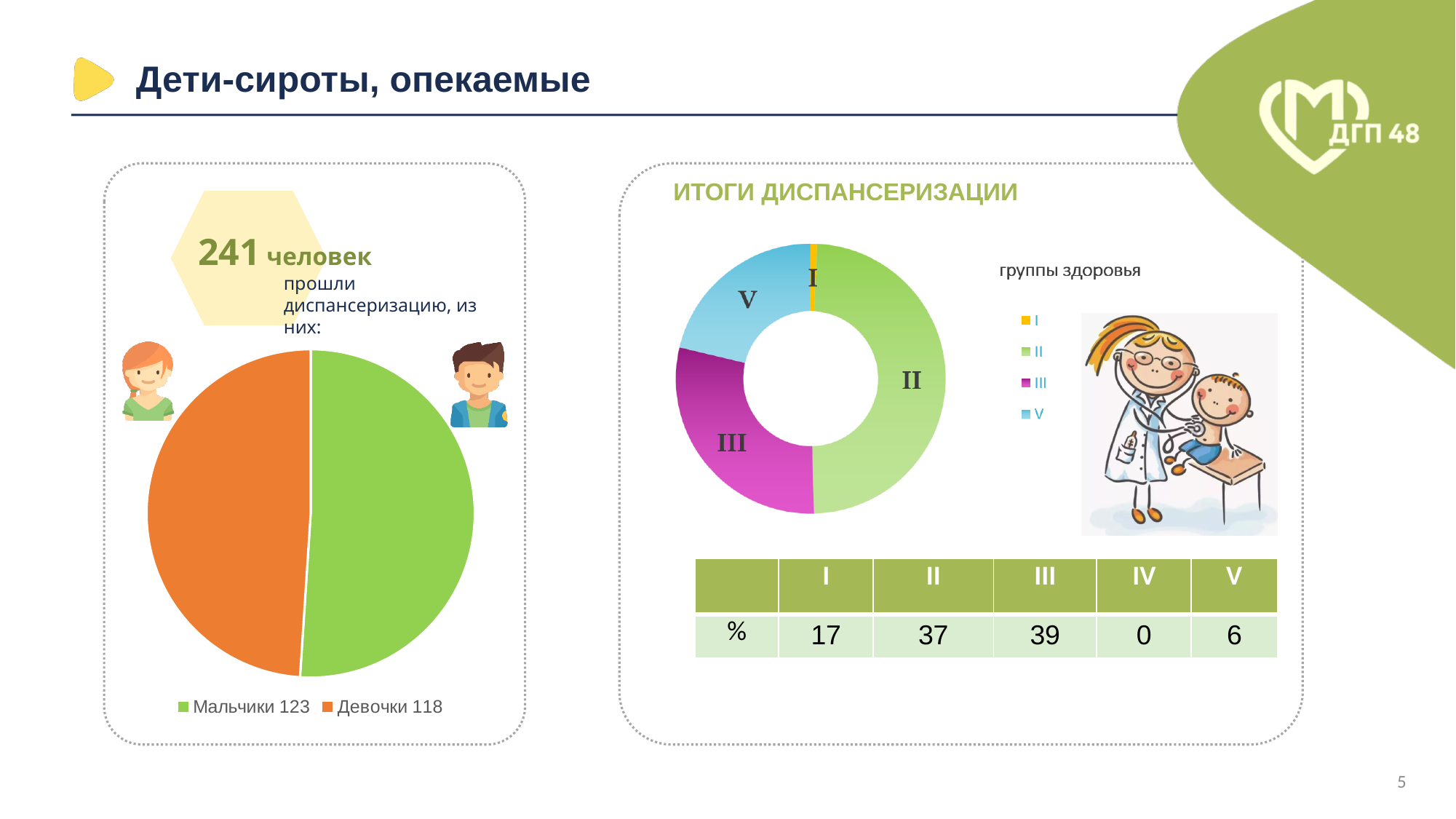
On the chart titled ИТОГИ ДИСПАНСЕРИЗАЦИИ, which health group has the largest segment? II On the left pie chart, what is the value for Мальчики? 123 What kind of chart is the one on the left of the slide? pie chart On the left pie chart, which category has the larger value, Мальчики or Девочки? Мальчики On the chart titled ИТОГИ ДИСПАНСЕРИЗАЦИИ, which health group has the smallest segment? I On the left pie chart, what is the difference between the values for Мальчики and Девочки? 5 On the left pie chart, what is the value for Девочки? 118 On the left pie chart, what colour is the Девочки slice? orange What kind of chart is the one titled ИТОГИ ДИСПАНСЕРИЗАЦИИ? doughnut chart On the left pie chart, how many categories are shown? 2 On the chart titled ИТОГИ ДИСПАНСЕРИЗАЦИИ, which segment is larger, III or V? III On the chart titled ИТОГИ ДИСПАНСЕРИЗАЦИИ, how many entries does the legend list? 4